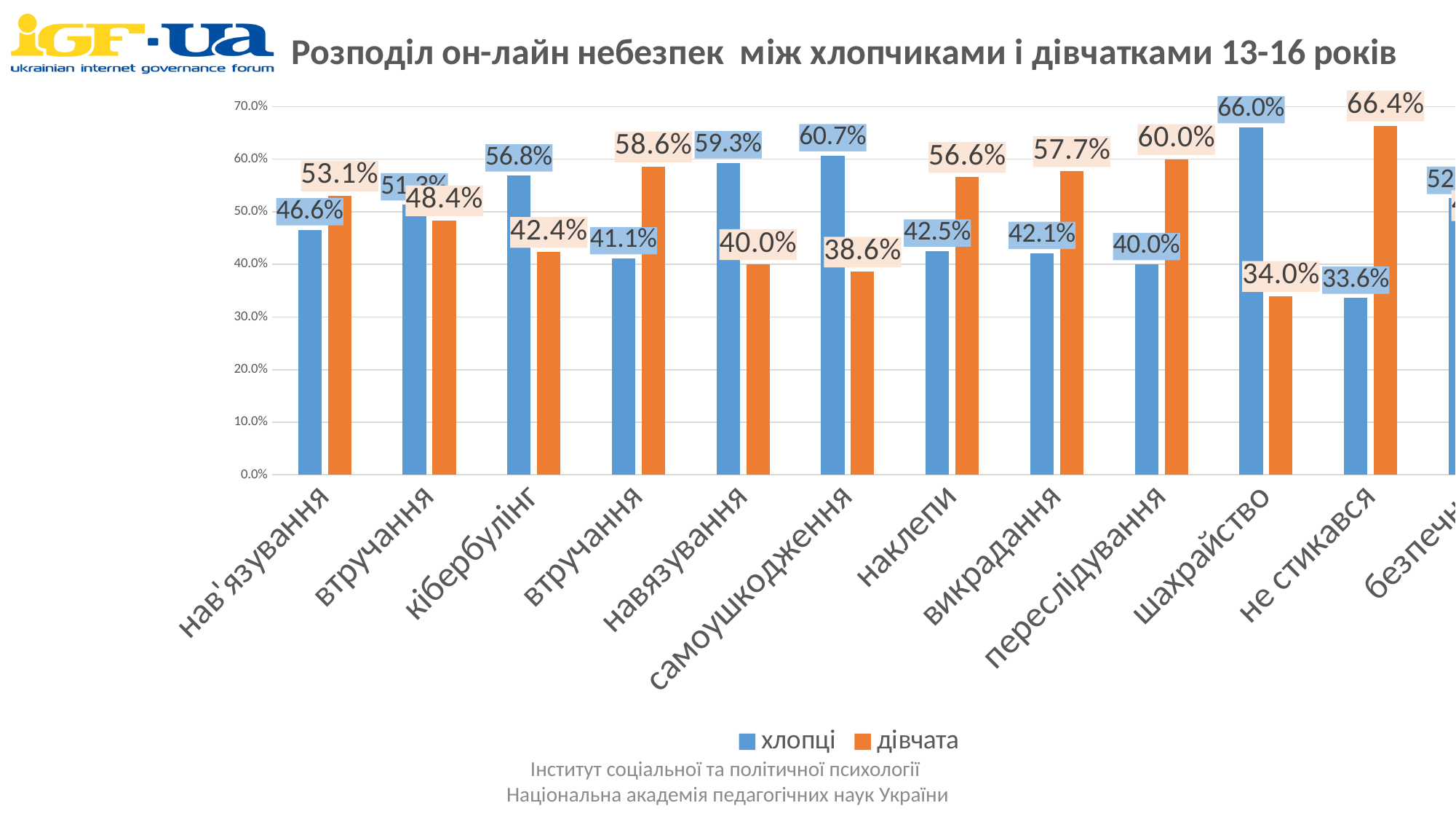
Which category has the lowest value for дівчата? шахрайство Which category has the highest value for дівчата? не стикався How many series does the legend list? 2 What is the value for хлопці in the самоушкодження category? 60.7% What is the value for хлопці in the кібербулінг category? 56.8% What kind of chart is shown on the slide? bar chart In the викрадання category, which is larger: the value for хлопці or for дівчата? дівчата Is the value for дівчата in the самоушкодження category greater or less than 40.0%? less What is the value for дівчата in the переслідування category? 60.0% What is the value for дівчата in the наклепи category? 56.6% What is the difference between the хлопці and дівчата values in the шахрайство category? 32.0% Which category has the highest value for хлопці? шахрайство